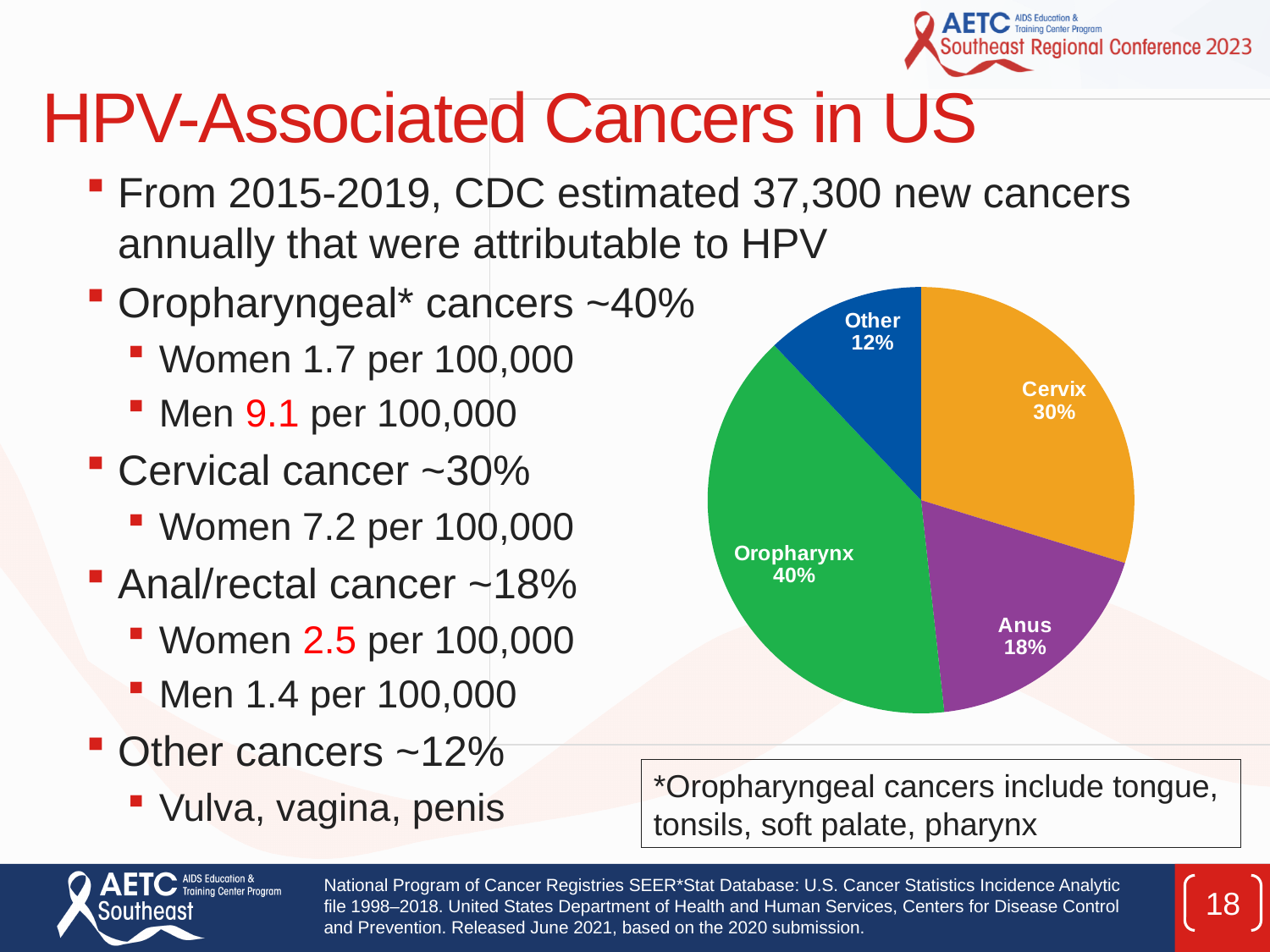
Which slice is larger, Anus or Other? Anus What is the difference in percentage points between the Cervix and Anus slices? 12 How many slices does the pie chart have? 4 What is the combined share of the Oropharynx and Cervix slices? 70% What share of the pie chart does Oropharynx represent? 40% What colour is the Cervix slice in the pie chart? orange Which slice of the pie chart is the smallest? Other What type of chart is shown on the slide? pie chart What share of the pie chart does Other represent? 12% What share of the pie chart does Anus represent? 18% Which slice of the pie chart is the largest? Oropharynx